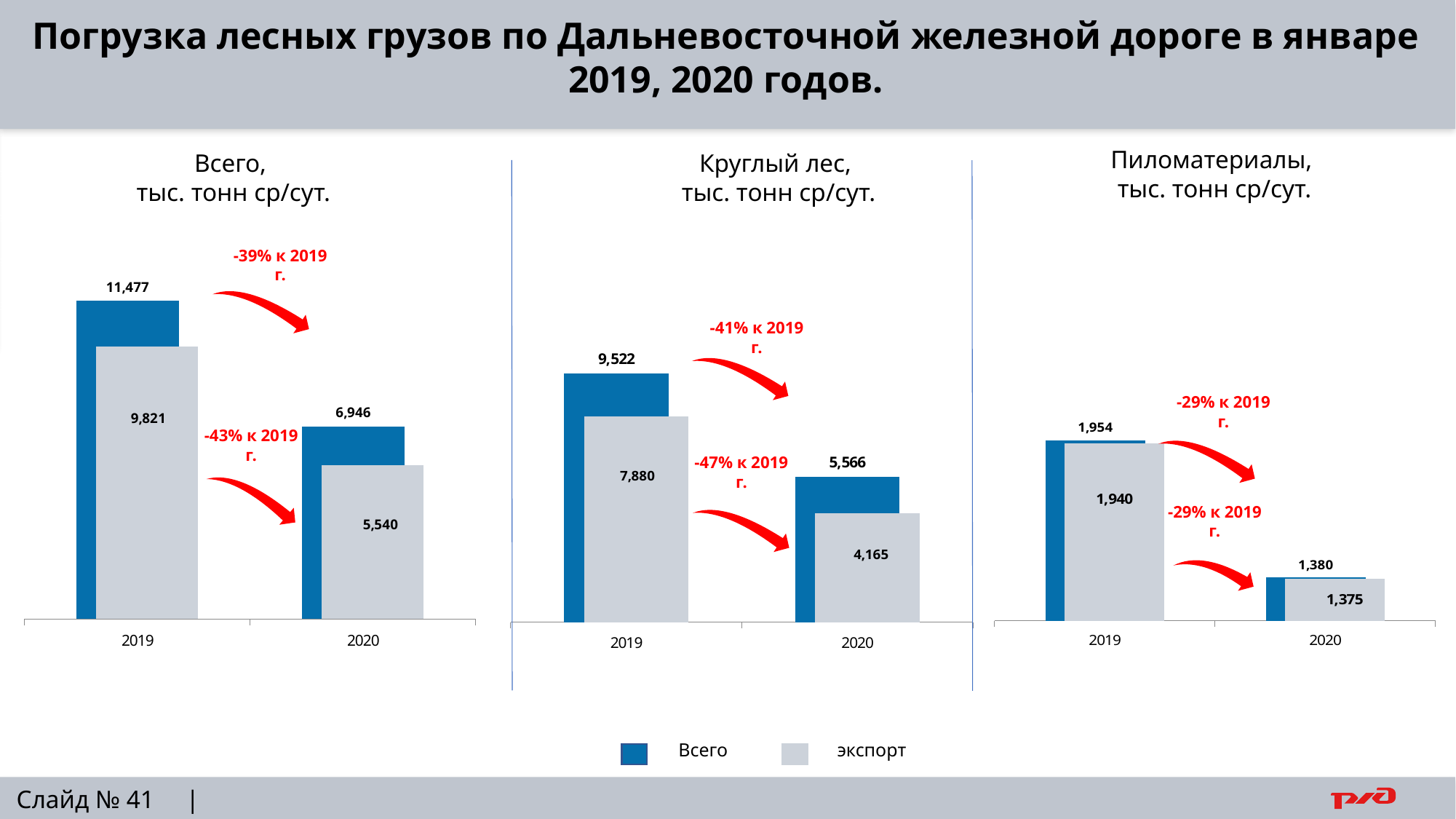
What percentage change relative to 2019 is annotated for the "Всего" series in the chart titled "Круглый лес, тыс. тонн ср/сут."? -41% к 2019 г. In the chart titled "Всего, тыс. тонн ср/сут.", what is the value of the "экспорт" series for 2020? 5,540 In the chart titled "Круглый лес, тыс. тонн ср/сут.", does the "Всего" series rise or fall from 2019 to 2020? fall In the chart titled "Всего, тыс. тонн ср/сут.", what is the value of the "Всего" series for 2019? 11,477 In the chart titled "Всего, тыс. тонн ср/сут.", what is the difference between the "Всего" values for 2019 and 2020? 4,531 How many year categories are shown on the x axis of the chart titled "Всего, тыс. тонн ср/сут."? 2 In the chart titled "Круглый лес, тыс. тонн ср/сут.", what is the value of the "экспорт" series for 2019? 7,880 In the chart titled "Пиломатериалы, тыс. тонн ср/сут.", what is the value of the "Всего" series for 2020? 1,380 How many series does the legend at the bottom of the slide list? 2 What kind of chart is the chart titled "Пиломатериалы, тыс. тонн ср/сут."? bar chart In the chart titled "Круглый лес, тыс. тонн ср/сут.", what is the difference between the "Всего" and "экспорт" values for 2020? 1,401 In the chart titled "Пиломатериалы, тыс. тонн ср/сут.", which year has the higher "экспорт" value, 2019 or 2020? 2019